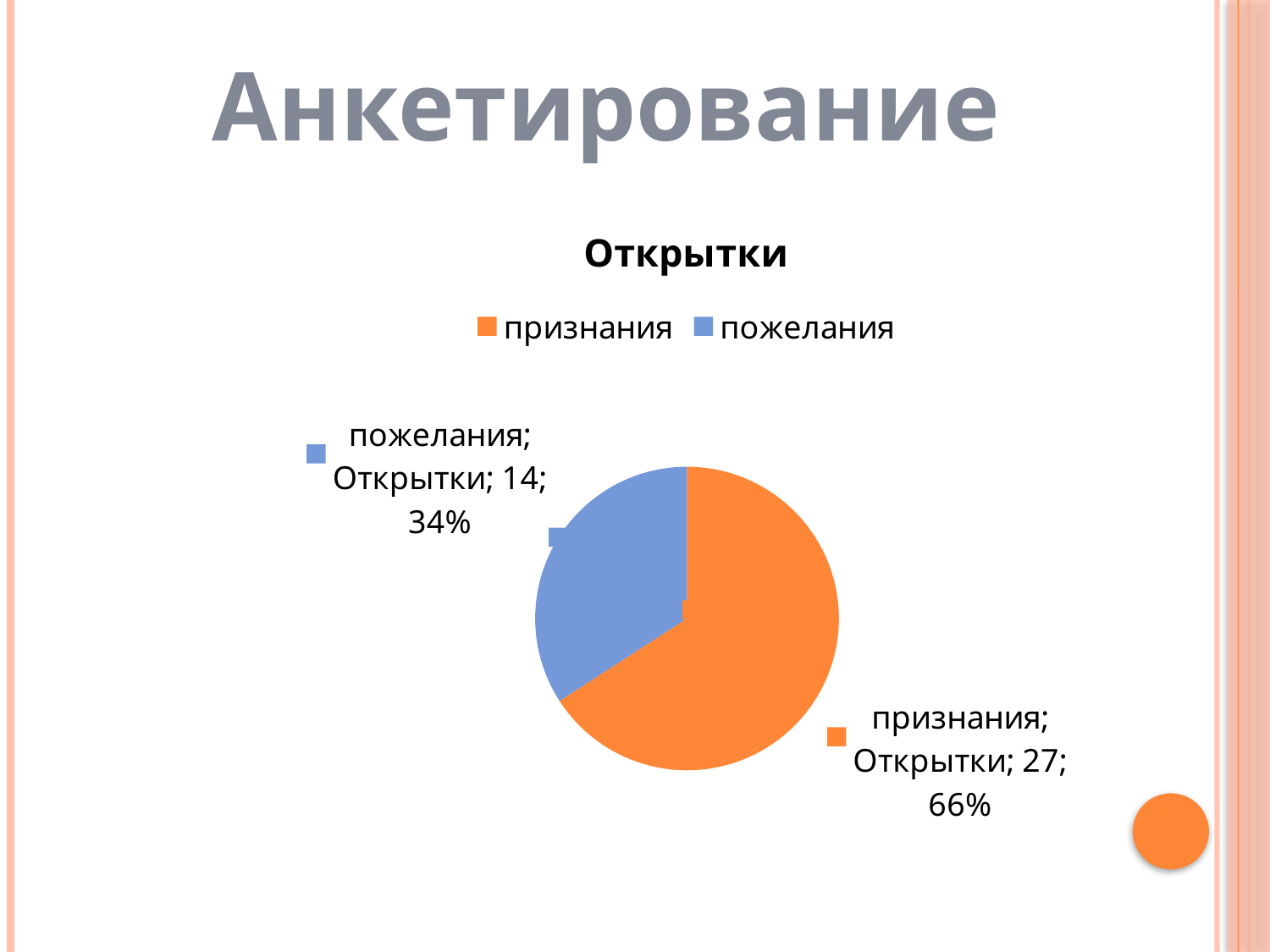
What share of the pie does признания take? 66% What is the difference between the values for признания and пожелания? 13 Which category has the smallest slice? пожелания What type of chart is shown on the slide? pie chart Which is larger, признания or пожелания? признания What is the value for признания? 27 What share of the pie does пожелания take? 34% What colour is the slice for пожелания? blue How many categories does the pie chart have? 2 Which category has the largest slice? признания What is the value for пожелания? 14 What is the title of the chart? Открытки